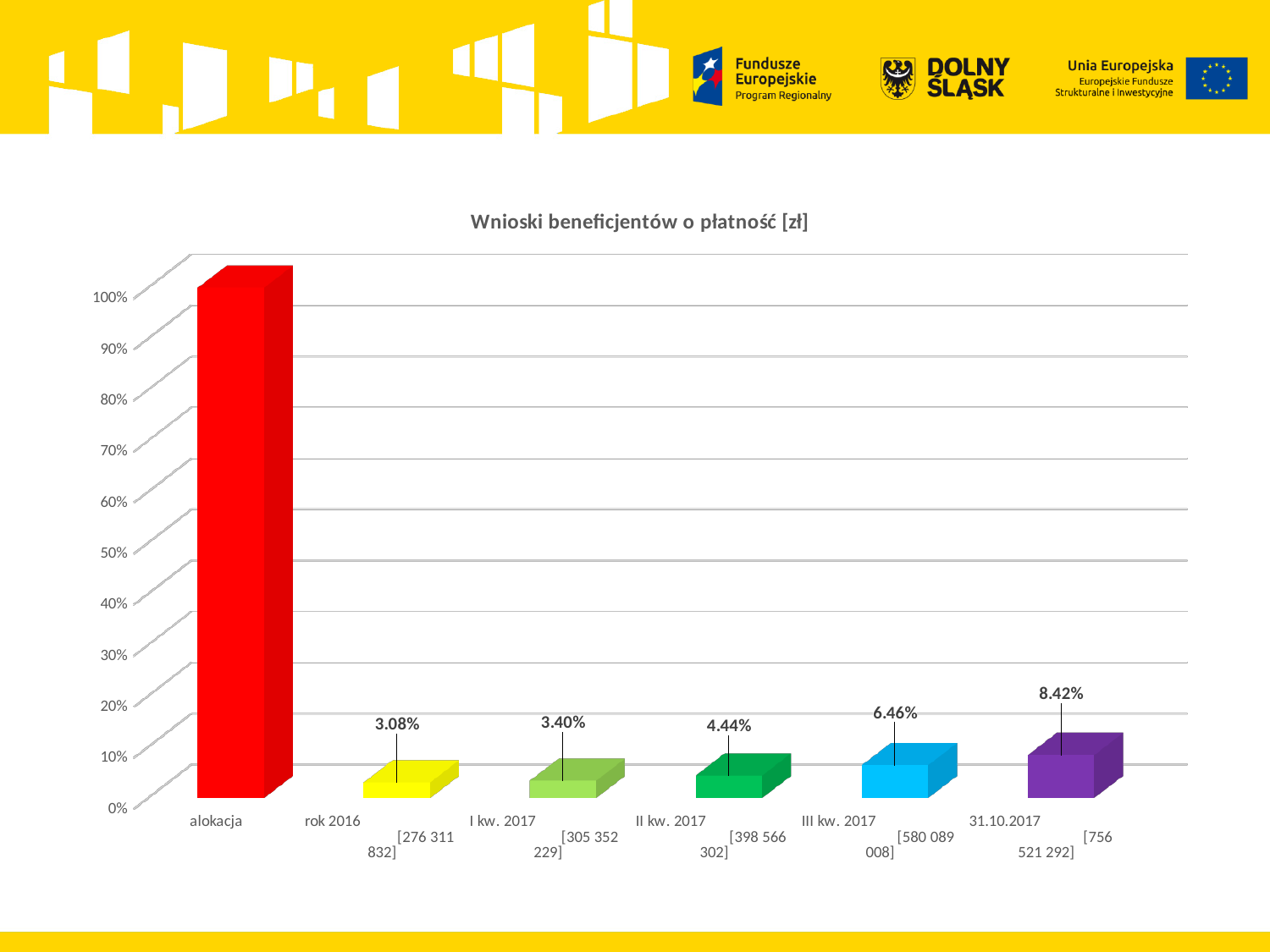
How many categories are shown on the x axis of the chart? 6 What is the difference in percentage points between 31.10.2017 and III kw. 2017? 1.96% What is the title of the chart? Wnioski beneficjentów o płatność [zł] Which category has the lowest percentage value? rok 2016 Is the value for alokacja greater or less than 50%? greater What percentage is shown for rok 2016? 3.08% What type of chart is shown on the slide? bar chart What percentage is shown for 31.10.2017? 8.42% What percentage is shown for I kw. 2017? 3.40% What percentage is shown for II kw. 2017? 4.44% Do the percentage values rise or fall from rok 2016 to 31.10.2017? rise What percentage is shown for III kw. 2017? 6.46%